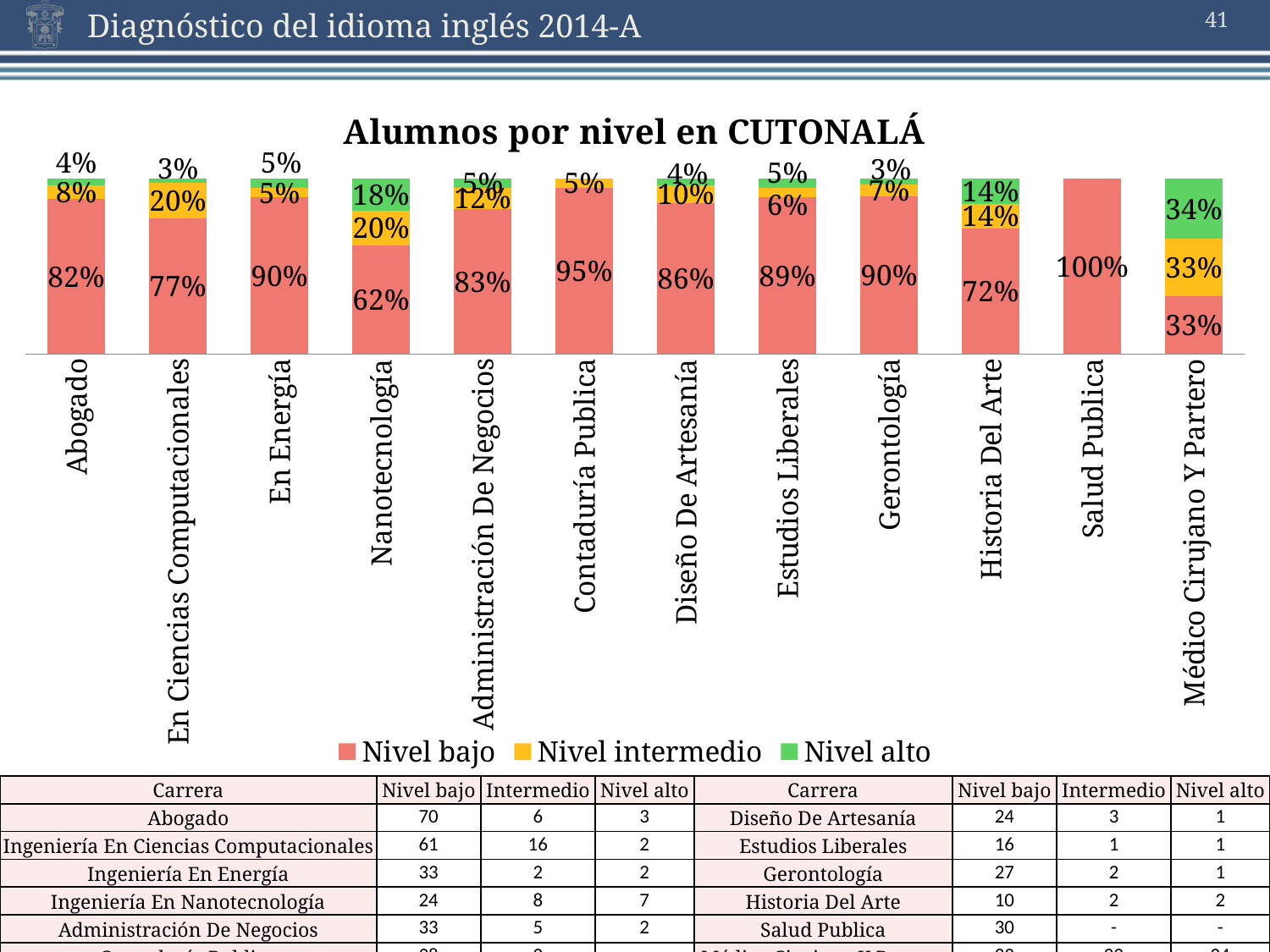
What is the difference between the Nivel bajo percentage for Contaduría Publica and for Abogado? 13% Which has a larger Nivel alto percentage, Nanotecnología or Estudios Liberales? Nanotecnología How many categories (carreras) are shown on the x axis of the chart? 12 Which category has the lowest Nivel bajo percentage? Médico Cirujano Y Partero What type of chart is shown on the slide? bar chart What is the Nivel alto percentage for Historia Del Arte? 14% Which legend entry is shown in green? Nivel alto What is the Nivel intermedio percentage for En Ciencias Computacionales? 20% What is the title of the chart? Alumnos por nivel en CUTONALÁ How many series does the legend list? 3 Which category has the highest Nivel bajo percentage? Salud Publica What is the Nivel bajo percentage for Nanotecnología? 62%